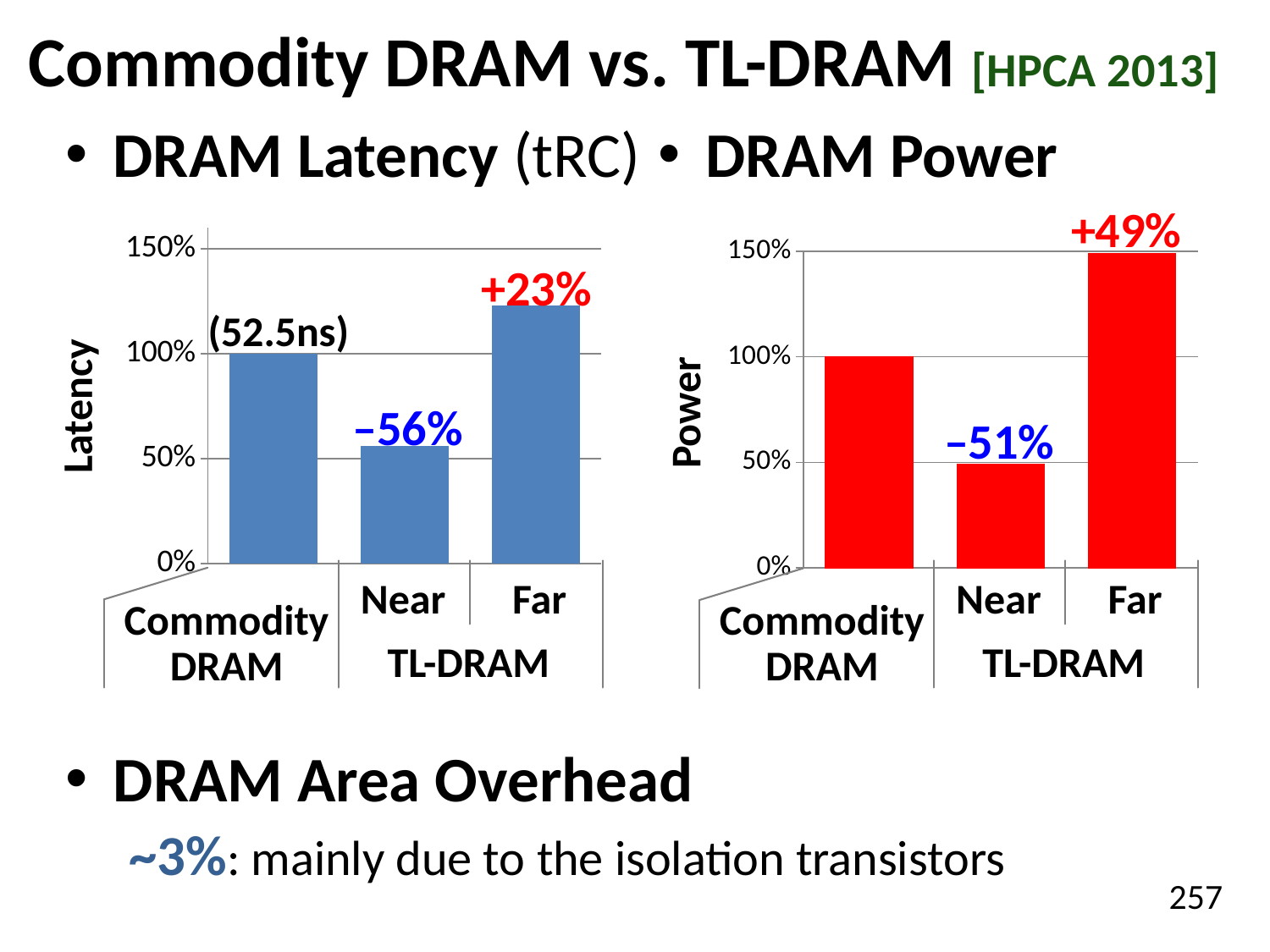
In the DRAM Latency chart, how many bars are plotted? 3 In the DRAM Latency chart, which bar is the highest? Far (TL-DRAM) What colour are the bars in the DRAM Power chart? red In the DRAM Power chart, is the value for the Far bar greater or less than 100%? greater In the DRAM Power chart, which bar is the highest? Far (TL-DRAM) In the DRAM Power chart, what percentage change is labelled above the Far bar? +49% In the DRAM Latency chart, what percentage change is labelled above the Far bar? +23% In the DRAM Latency chart, which bar is the lowest? Near (TL-DRAM) In the DRAM Latency chart, what absolute latency is shown in parentheses above the Commodity DRAM bar? (52.5ns) What kind of chart is the DRAM Latency chart on the left? bar chart In the DRAM Latency chart, is the value for the Near bar greater or less than 50%? greater In the DRAM Latency chart, what percentage change is labelled above the Near bar? –56%